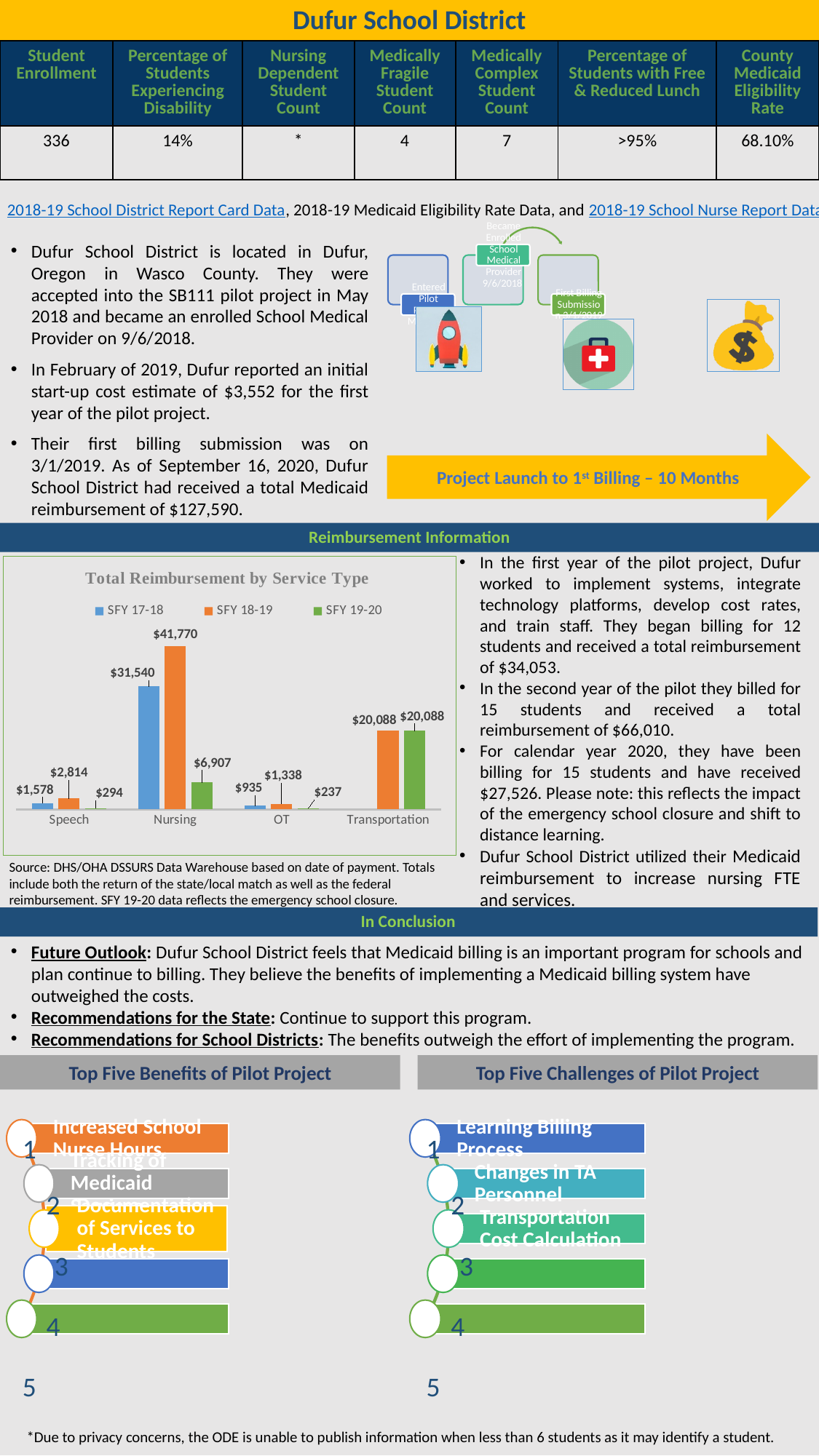
Which series in 'Total Reimbursement by Service Type' is shown in green? SFY 19-20 In 'Total Reimbursement by Service Type', what is the SFY 17-18 value for Speech? $1,578 In 'Total Reimbursement by Service Type', which service type has the lowest SFY 19-20 value? OT In 'Total Reimbursement by Service Type', what is the SFY 19-20 value for OT? $237 What kind of chart is 'Total Reimbursement by Service Type'? Bar chart In 'Total Reimbursement by Service Type', which is larger for Speech: the SFY 18-19 value or the SFY 19-20 value? SFY 18-19 In 'Total Reimbursement by Service Type', what is the difference between the SFY 18-19 and SFY 17-18 values for Nursing? $10,230 How many series does the legend of 'Total Reimbursement by Service Type' list? 3 In 'Total Reimbursement by Service Type', what is the SFY 19-20 value for Transportation? $20,088 In 'Total Reimbursement by Service Type', what is the SFY 18-19 value for Nursing? $41,770 How many service type categories are shown on the x axis of 'Total Reimbursement by Service Type'? 4 In 'Total Reimbursement by Service Type', which service type has the highest SFY 18-19 value? Nursing